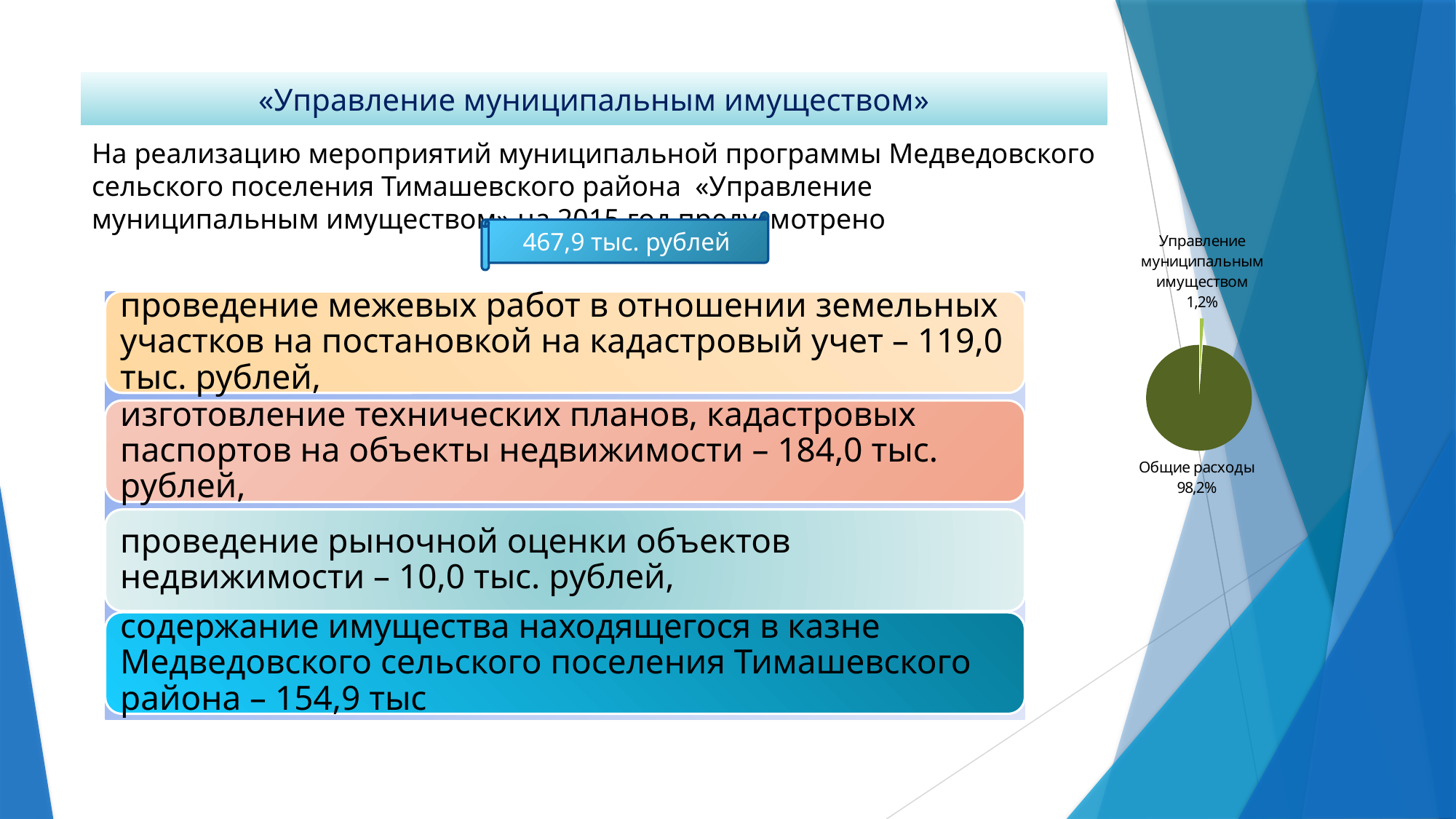
Is the share for "Общие расходы" in the pie chart greater or less than 50%? greater Which slice of the pie chart is the largest? Общие расходы What colour is the "Общие расходы" slice in the pie chart? Dark olive green What kind of chart is shown on the right side of the slide? Pie chart What is the difference in percentage points between the "Общие расходы" slice and the "Управление муниципальным имуществом" slice in the pie chart? 97,0 Which slice of the pie chart is the smallest? Управление муниципальным имуществом In the pie chart, what share is labelled for "Управление муниципальным имуществом"? 1,2% How many slices does the pie chart have? 2 In the pie chart, what share is labelled for "Общие расходы"? 98,2% In the pie chart, which is larger: "Общие расходы" or "Управление муниципальным имуществом"? Общие расходы